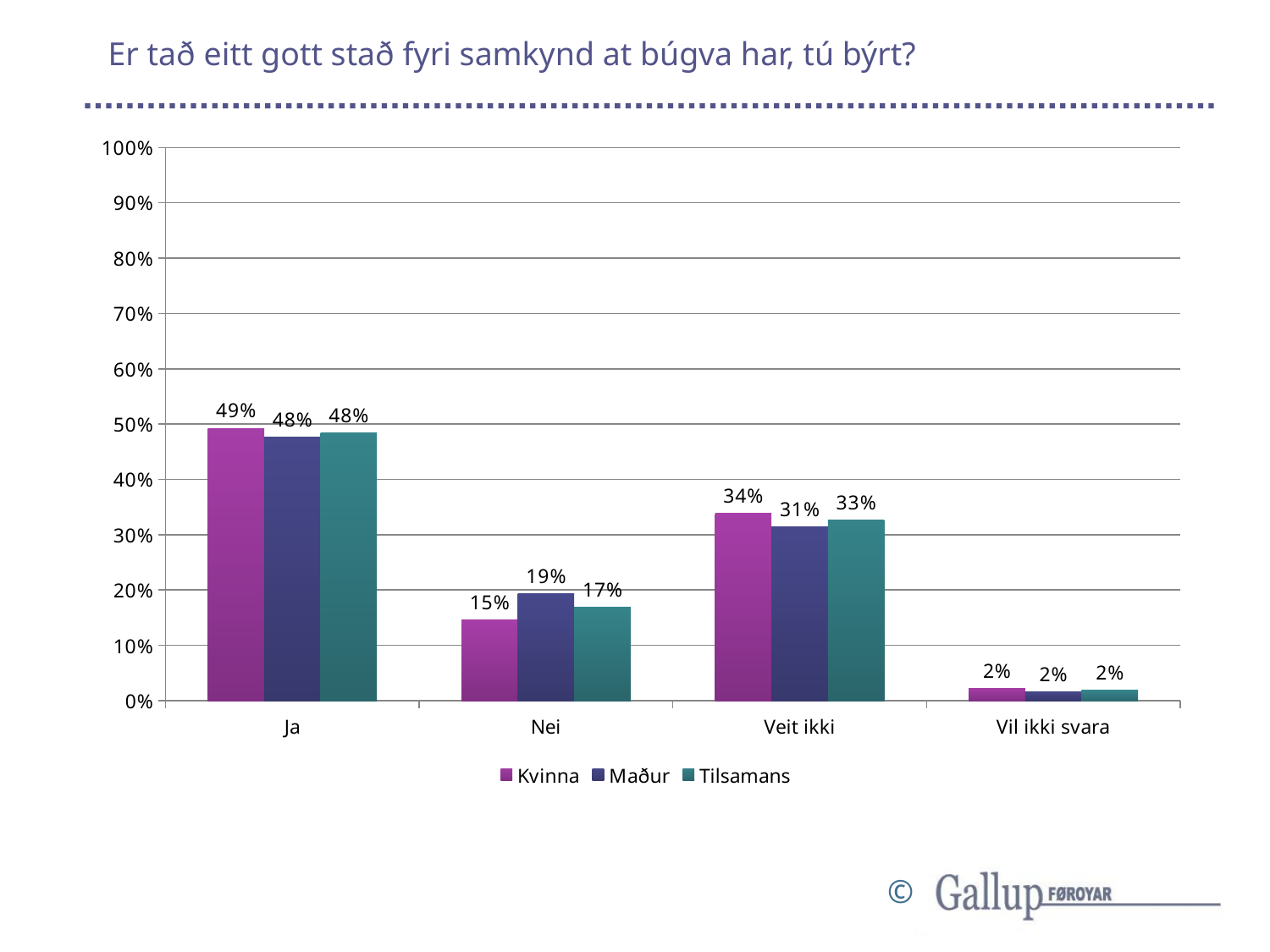
What are the three series listed in the legend? Kvinna, Maður, Tilsamans What is the value for Tilsamans in the Veit ikki category? 33% What kind of chart is shown on the slide? Bar chart What is the value for Kvinna in the Vil ikki svara category? 2% Which category has the highest value for Tilsamans? Ja Which category has the lowest value for Maður? Vil ikki svara What is the value for Maður in the Nei category? 19% In the Veit ikki category, which is larger: the Kvinna value or the Maður value? Kvinna What is the difference between the Kvinna and Maður values in the Nei category? 4% How many categories are shown on the x axis? 4 What is the value for Kvinna in the Ja category? 49% How many series does the legend list? 3